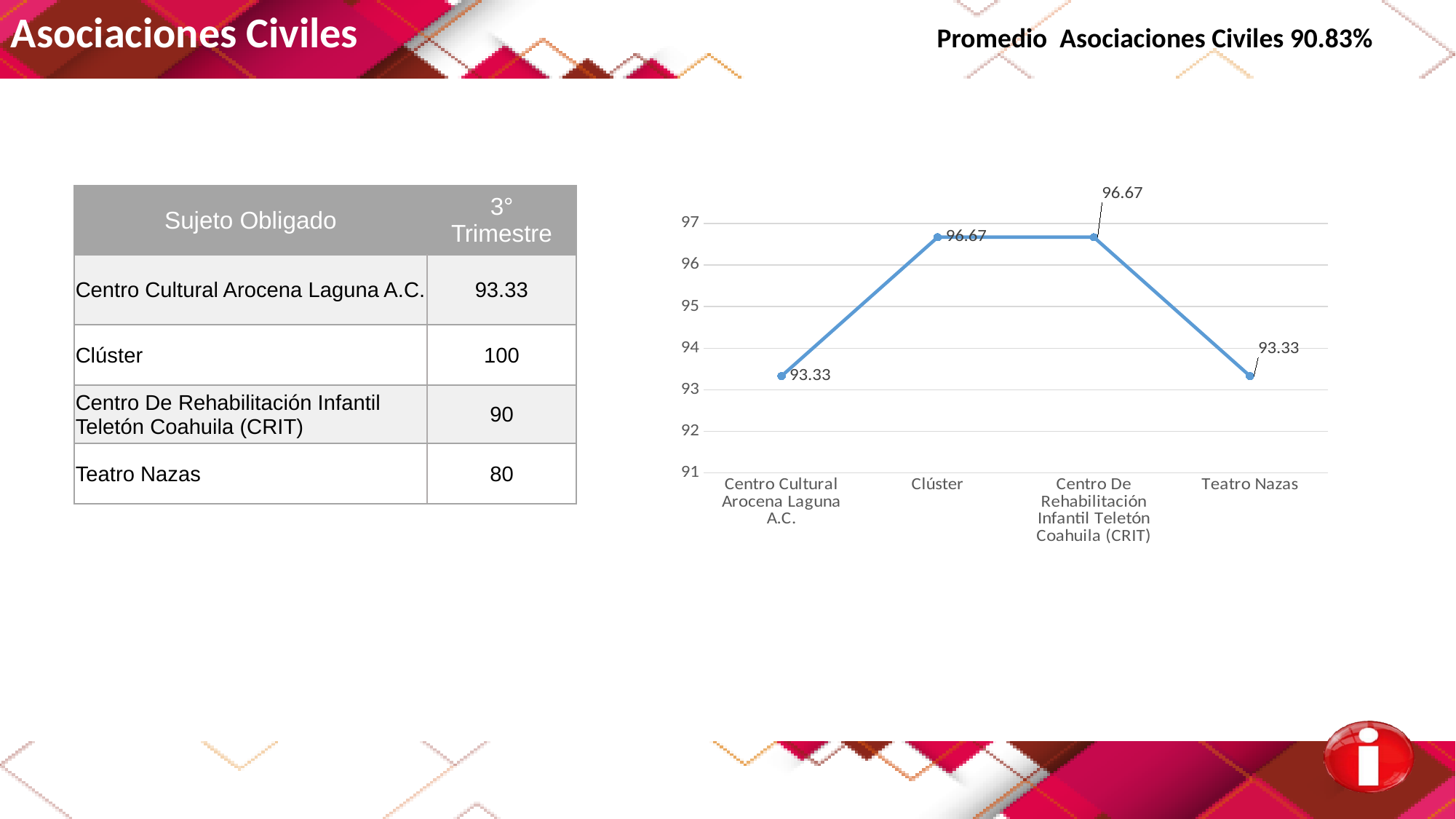
How many categories are plotted on the chart? 4 What is the lowest value shown on the chart's vertical axis? 91 What is the value plotted for Centro De Rehabilitación Infantil Teletón Coahuila (CRIT) on the chart? 96.67 On the chart, is the value for Clúster greater or less than 95? greater On the chart, which is larger: the value for Clúster or the value for Teatro Nazas? Clúster On the chart, what is the difference between the value for Clúster and the value for Centro Cultural Arocena Laguna A.C.? 3.34 On the chart, does the line rise or fall from Centro De Rehabilitación Infantil Teletón Coahuila (CRIT) to Teatro Nazas? fall On the chart, is the value for Teatro Nazas greater or less than 94? less What is the value plotted for Teatro Nazas on the chart? 93.33 What is the value plotted for Clúster on the chart? 96.67 What is the value plotted for Centro Cultural Arocena Laguna A.C. on the chart? 93.33 What kind of chart is shown on the slide? line chart